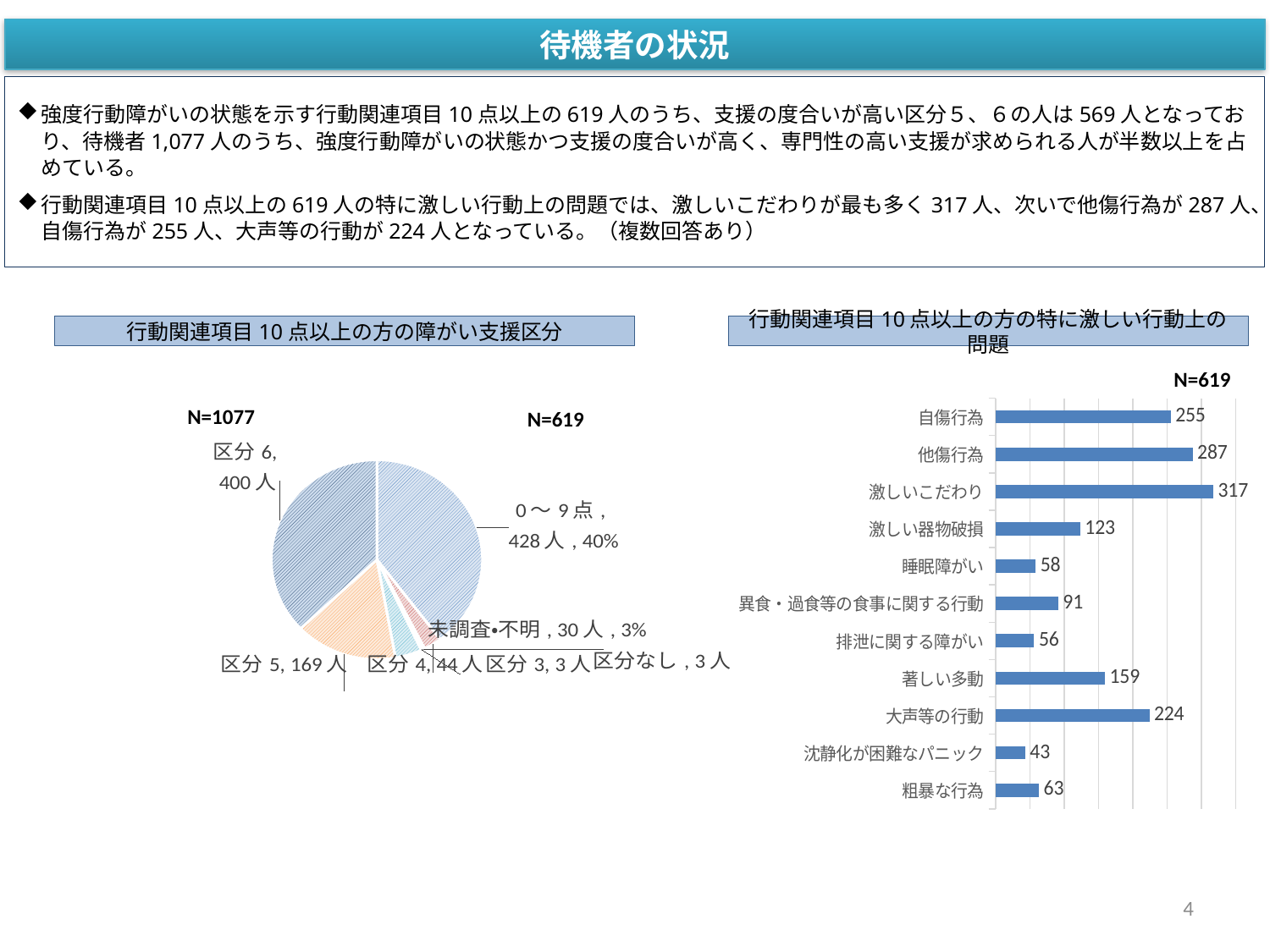
In the pie chart titled 行動関連項目10点以上の方の障がい支援区分, how many people are in 区分6? 400人 What kind of chart is the chart on the right side of the slide? bar chart In the pie chart titled 行動関連項目10点以上の方の障がい支援区分, which is larger, 区分5 or 区分4? 区分5 In the bar chart titled 行動関連項目10点以上の方の特に激しい行動上の問題, what is the value for 著しい多動? 159 What is the N value shown above the bar chart titled 行動関連項目10点以上の方の特に激しい行動上の問題? N=619 In the bar chart titled 行動関連項目10点以上の方の特に激しい行動上の問題, which category has the highest value? 激しいこだわり In the bar chart titled 行動関連項目10点以上の方の特に激しい行動上の問題, what is the difference between the values for 他傷行為 and 自傷行為? 32 In the bar chart titled 行動関連項目10点以上の方の特に激しい行動上の問題, which is larger, 大声等の行動 or 激しい器物破損? 大声等の行動 In the pie chart titled 行動関連項目10点以上の方の障がい支援区分, what share of the pie is 0～9点? 40% In the bar chart titled 行動関連項目10点以上の方の特に激しい行動上の問題, which category has the lowest value? 沈静化が困難なパニック In the bar chart titled 行動関連項目10点以上の方の特に激しい行動上の問題, what is the value for 激しいこだわり? 317 How many categories are shown in the bar chart titled 行動関連項目10点以上の方の特に激しい行動上の問題? 11